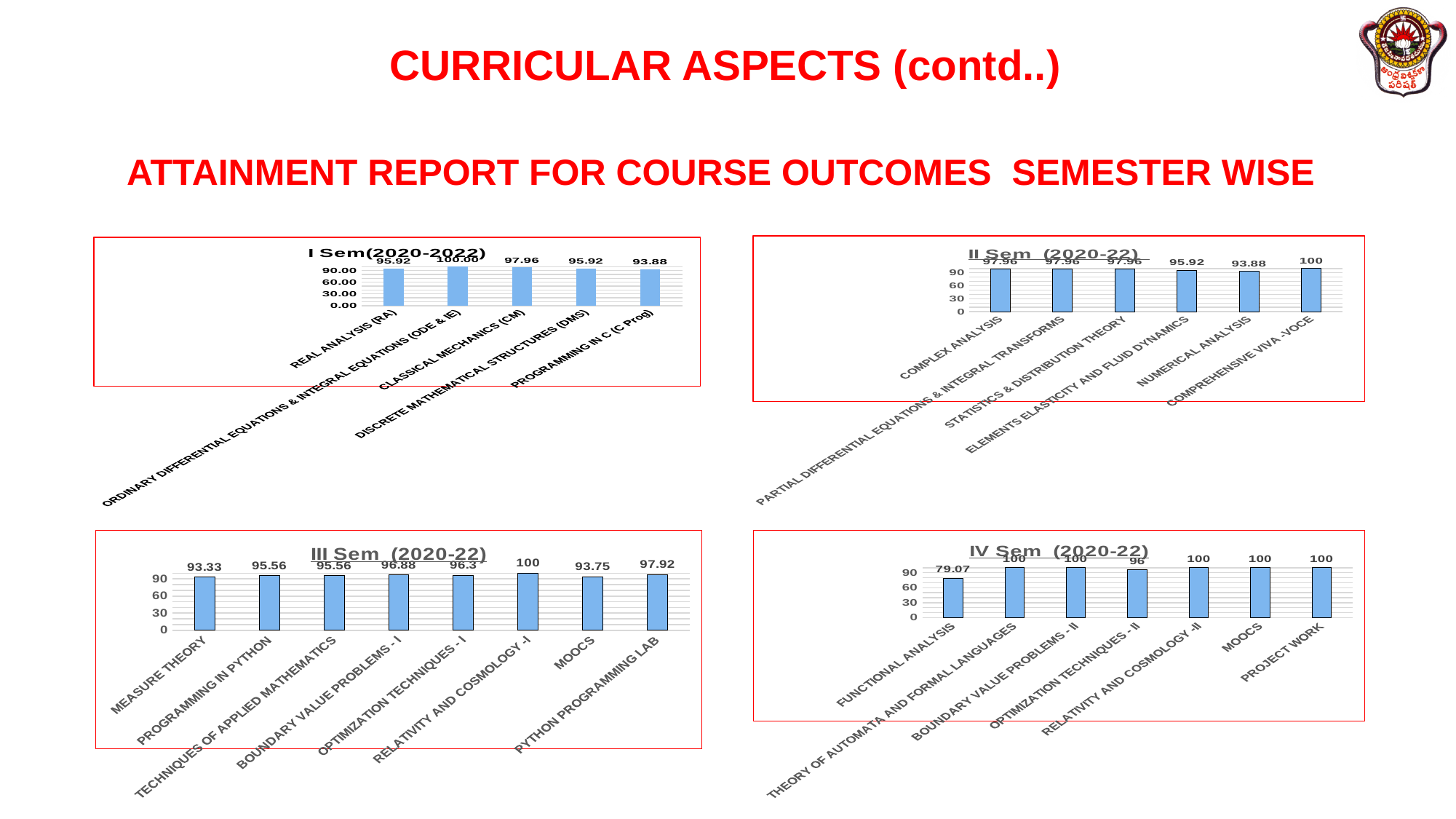
In the II Sem (2020-22) chart, what is the value for NUMERICAL ANALYSIS? 93.88 In the I Sem(2020-2022) chart, which course has the lowest value? PROGRAMMING IN C (C Prog) In the II Sem (2020-22) chart, what is the difference between COMPREHENSIVE VIVA-VOCE and ELEMENTS ELASTICITY AND FLUID DYNAMICS? 4.08 What type of chart is the IV Sem (2020-22) chart? Bar chart In the IV Sem (2020-22) chart, how many courses are plotted? 7 In the III Sem (2020-22) chart, which course has the lowest value? MEASURE THEORY In the III Sem (2020-22) chart, what is the value for BOUNDARY VALUE PROBLEMS - I? 96.88 In the I Sem(2020-2022) chart, what is the value for CLASSICAL MECHANICS (CM)? 97.96 In the IV Sem (2020-22) chart, what is the value for FUNCTIONAL ANALYSIS? 79.07 In the III Sem (2020-22) chart, which is larger, PYTHON PROGRAMMING LAB or MOOCS? PYTHON PROGRAMMING LAB In the II Sem (2020-22) chart, how many courses are plotted? 6 In the I Sem(2020-2022) chart, which course has the highest value? ORDINARY DIFFERENTIAL EQUATIONS & INTEGRAL EQUATIONS (ODE & IE)